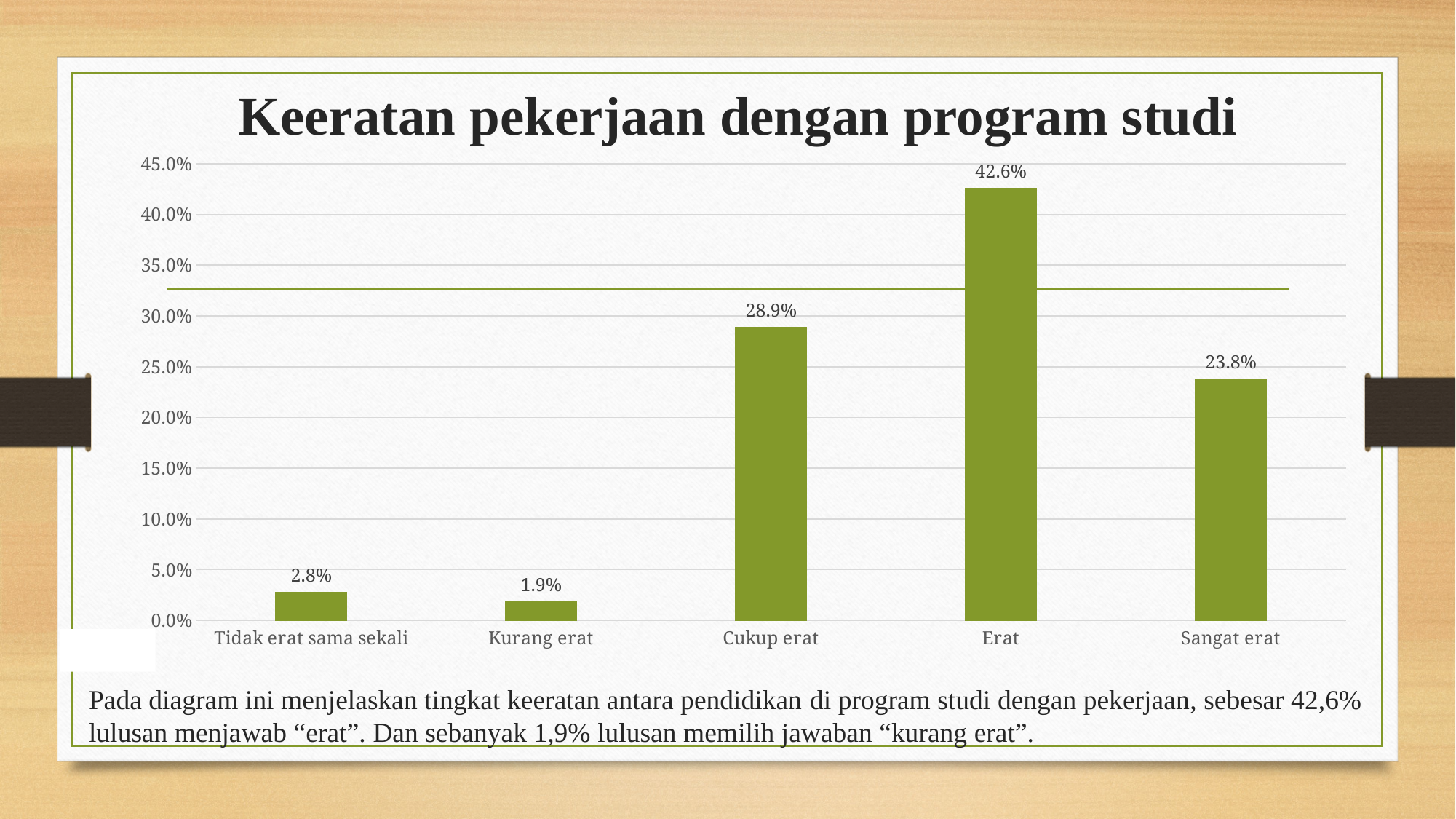
How many categories are shown on the x axis? 5 Is the value for Cukup erat greater or less than 25.0%? greater What is the value for Kurang erat? 1.9% What is the value for Sangat erat? 23.8% Which category has the lowest value? Kurang erat Which is larger, the value for Cukup erat or the value for Sangat erat? Cukup erat Which category has the highest value? Erat What is the value for Erat? 42.6% What is the value for Tidak erat sama sekali? 2.8% What kind of chart is shown on the slide? bar chart What is the title of the chart? Keeratan pekerjaan dengan program studi What is the difference between the values for Erat and Cukup erat? 13.7%